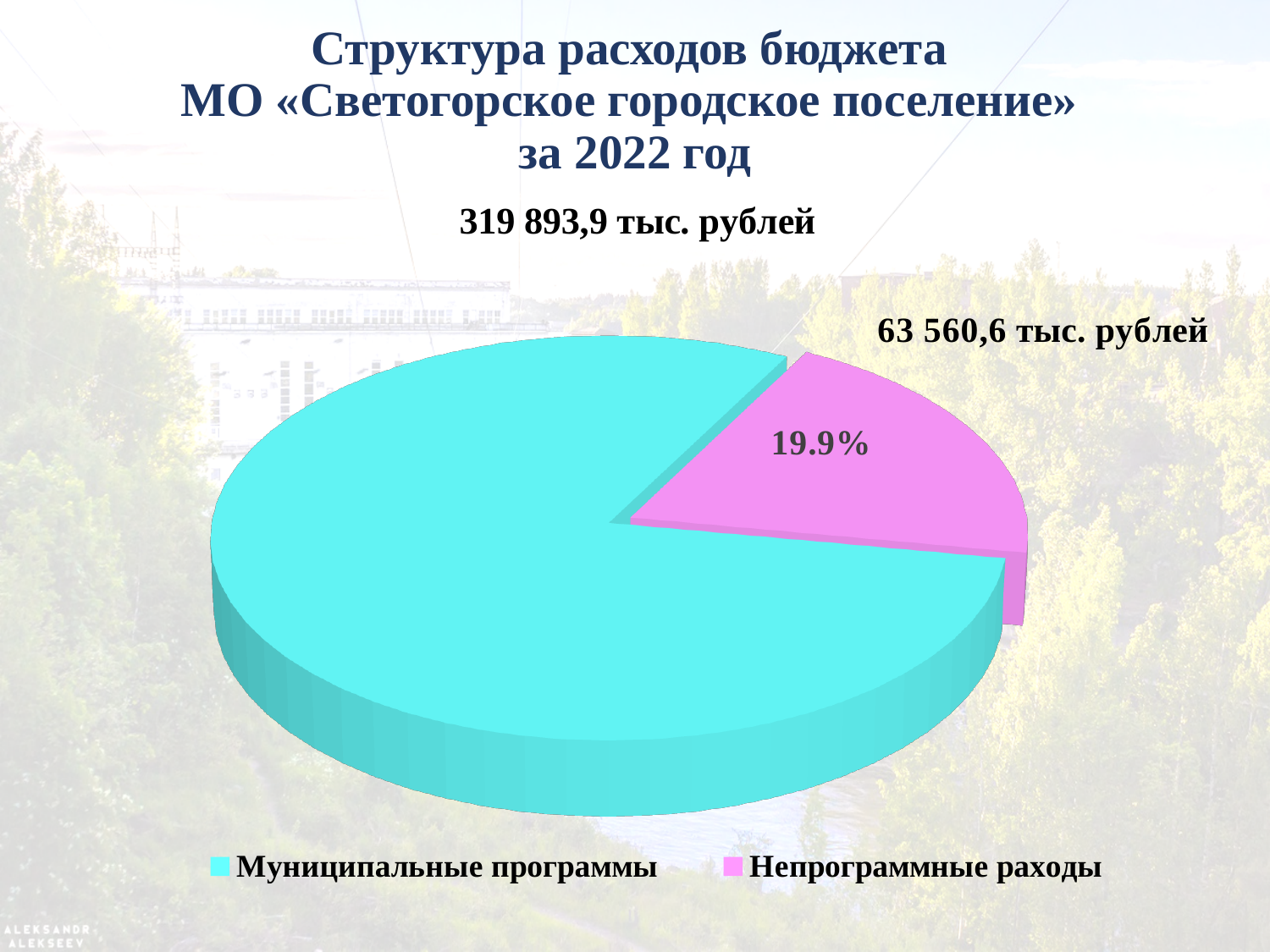
How many entries does the legend list? 2 Which category has the smallest slice of the pie? Непрограммные раходы Is the share of Муниципальные программы greater or less than 50%? greater What kind of chart is shown on the slide? Pie chart Which is larger, Муниципальные программы or Непрограммные раходы? Муниципальные программы What percentage share is printed on the Непрограммные раходы slice? 19.9% How many slices does the pie chart have? 2 What colour is the Непрограммные раходы slice? Pink Which category has the largest slice of the pie? Муниципальные программы What value is shown for Непрограммные раходы? 63 560,6 тыс. рублей